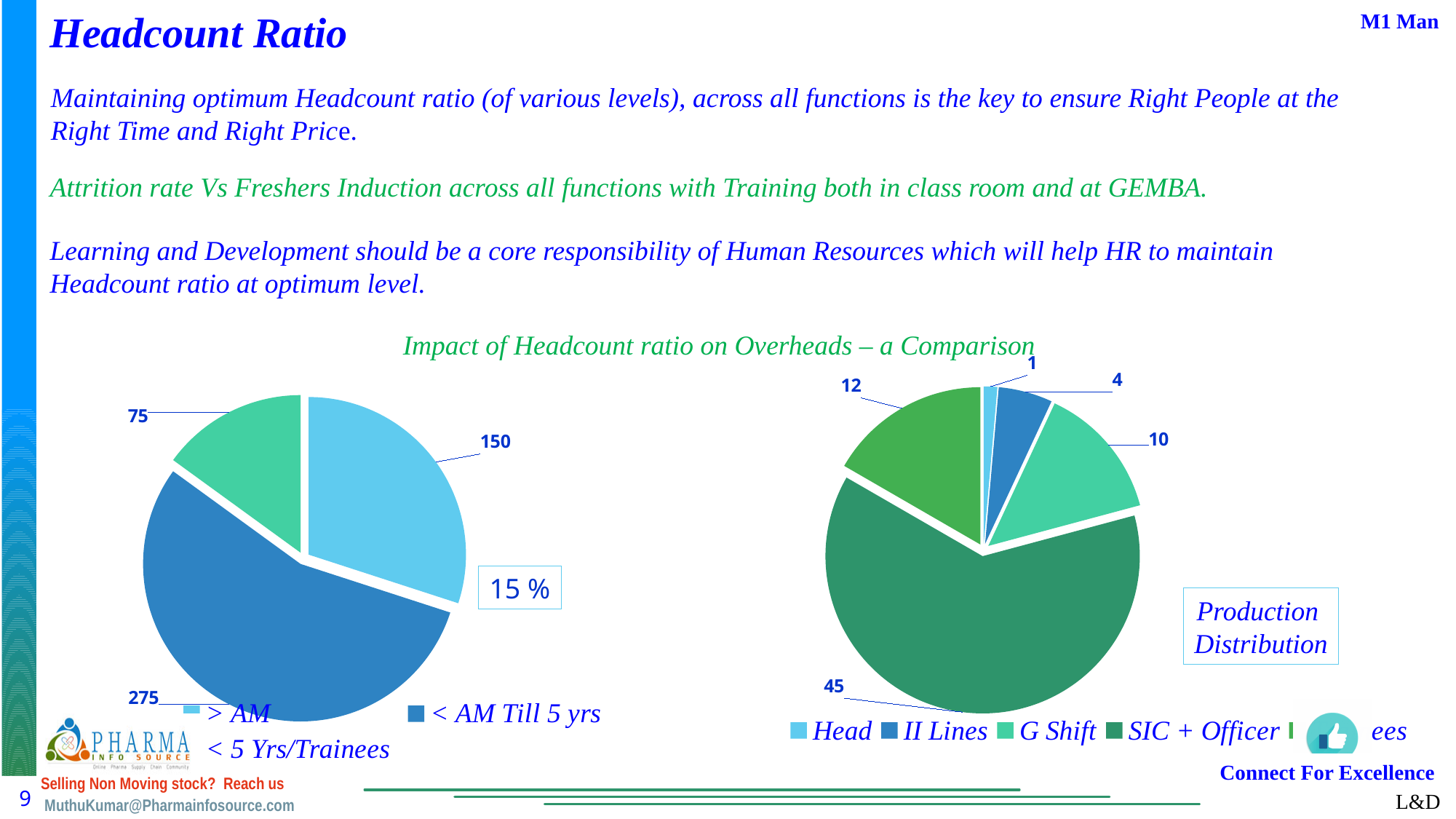
In the left pie chart, what share of the total does the '< 5 Yrs/Trainees' slice represent? 15% In the right pie chart (Production Distribution), which is larger: 'II Lines' or 'G Shift'? G Shift How many slices does the right pie chart (Production Distribution) have? 5 In the left pie chart, what is the difference between the '< AM Till 5 yrs' and '> AM' values? 125 In the left pie chart, what is the value for '< AM Till 5 yrs'? 275 In the right pie chart (Production Distribution), what is the value for 'SIC + Officer'? 45 In the right pie chart (Production Distribution), which category has the smallest slice? Head In the left pie chart, which category has the largest slice? < AM Till 5 yrs What type of charts are shown on the slide? Pie charts In the left pie chart, what is the value for '< 5 Yrs/Trainees'? 75 In the right pie chart (Production Distribution), what is the value for 'G Shift'? 10 In the left pie chart, what is the value for '> AM'? 150